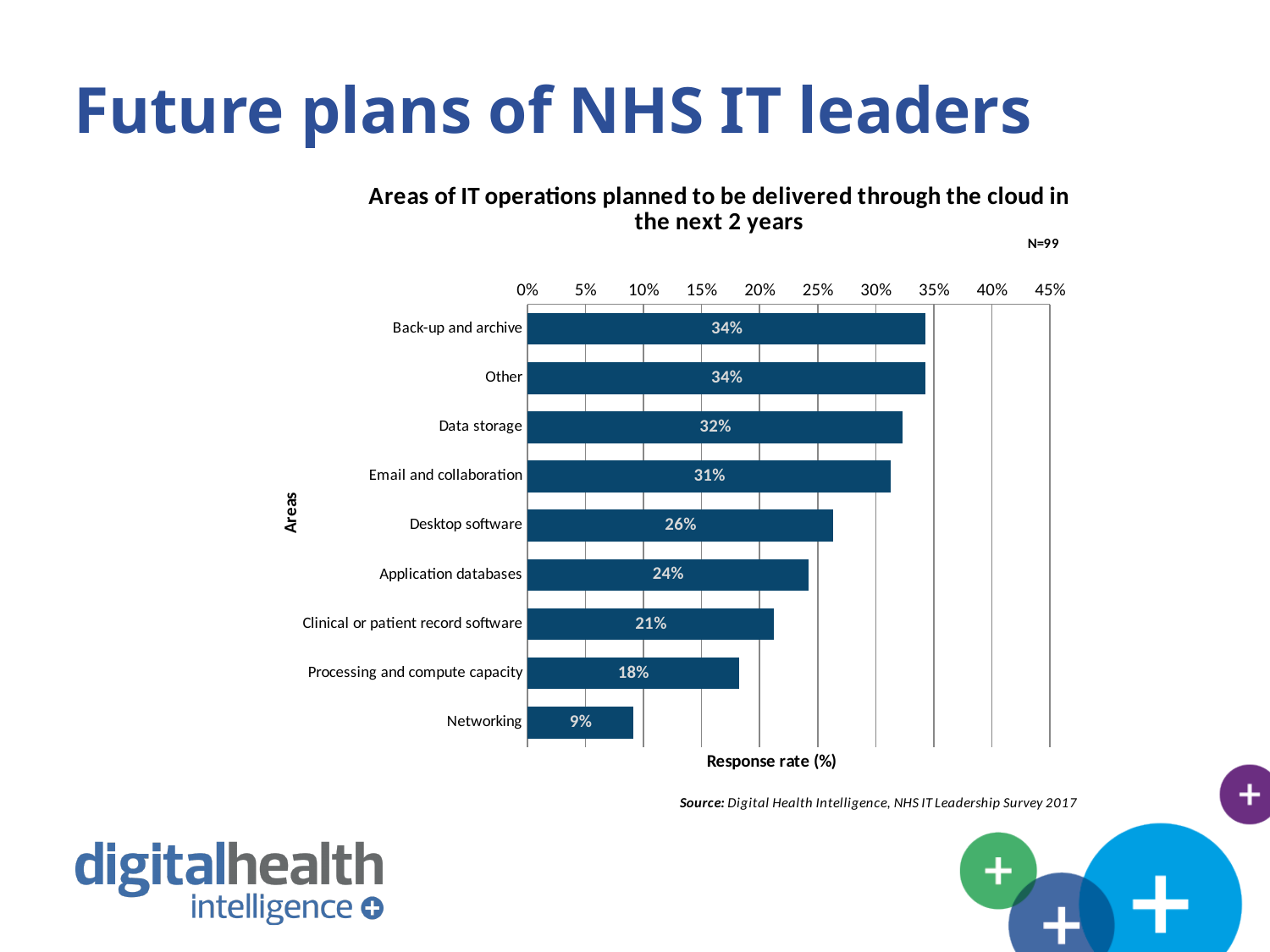
What kind of chart is shown on the slide? Bar chart What is the title of the chart? Areas of IT operations planned to be delivered through the cloud in the next 2 years What is the response rate for Data storage? 32% What is the sample size (N) shown on the chart? N=99 Which has a higher response rate, Email and collaboration or Processing and compute capacity? Email and collaboration What is the response rate for Networking? 9% What is the difference in response rate between Back-up and archive and Networking? 25% What is the difference in response rate between Desktop software and Application databases? 2% Which area has the lowest response rate? Networking How many areas are shown in the chart? 9 What is the response rate for Clinical or patient record software? 21% Is the value for Desktop software greater or less than 25%? greater